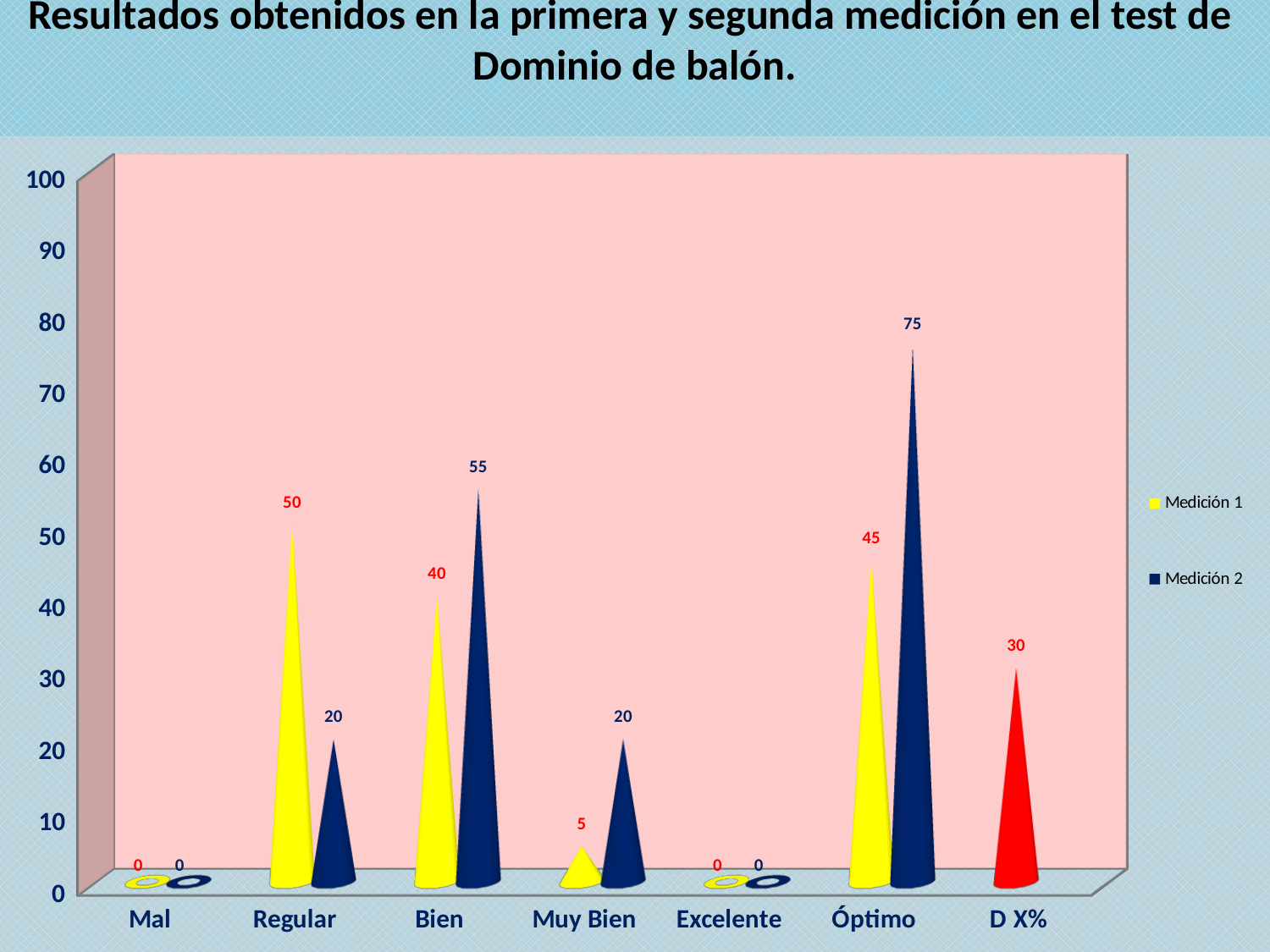
How many categories are shown on the x axis? 7 What is the value of Medición 2 for Óptimo? 75 What is the value of Medición 1 for Regular? 50 What is the difference between Medición 2 and Medición 1 for Óptimo? 30 What value is shown for the D X% category? 30 What is the value of Medición 2 for Bien? 55 For Regular, which is larger: Medición 1 or Medición 2? Medición 1 What kind of chart is shown on the slide? Bar chart Which category has the highest Medición 1 value? Regular Which category has the highest Medición 2 value? Óptimo How many series does the legend list? 2 For Bien, which is larger: Medición 1 or Medición 2? Medición 2